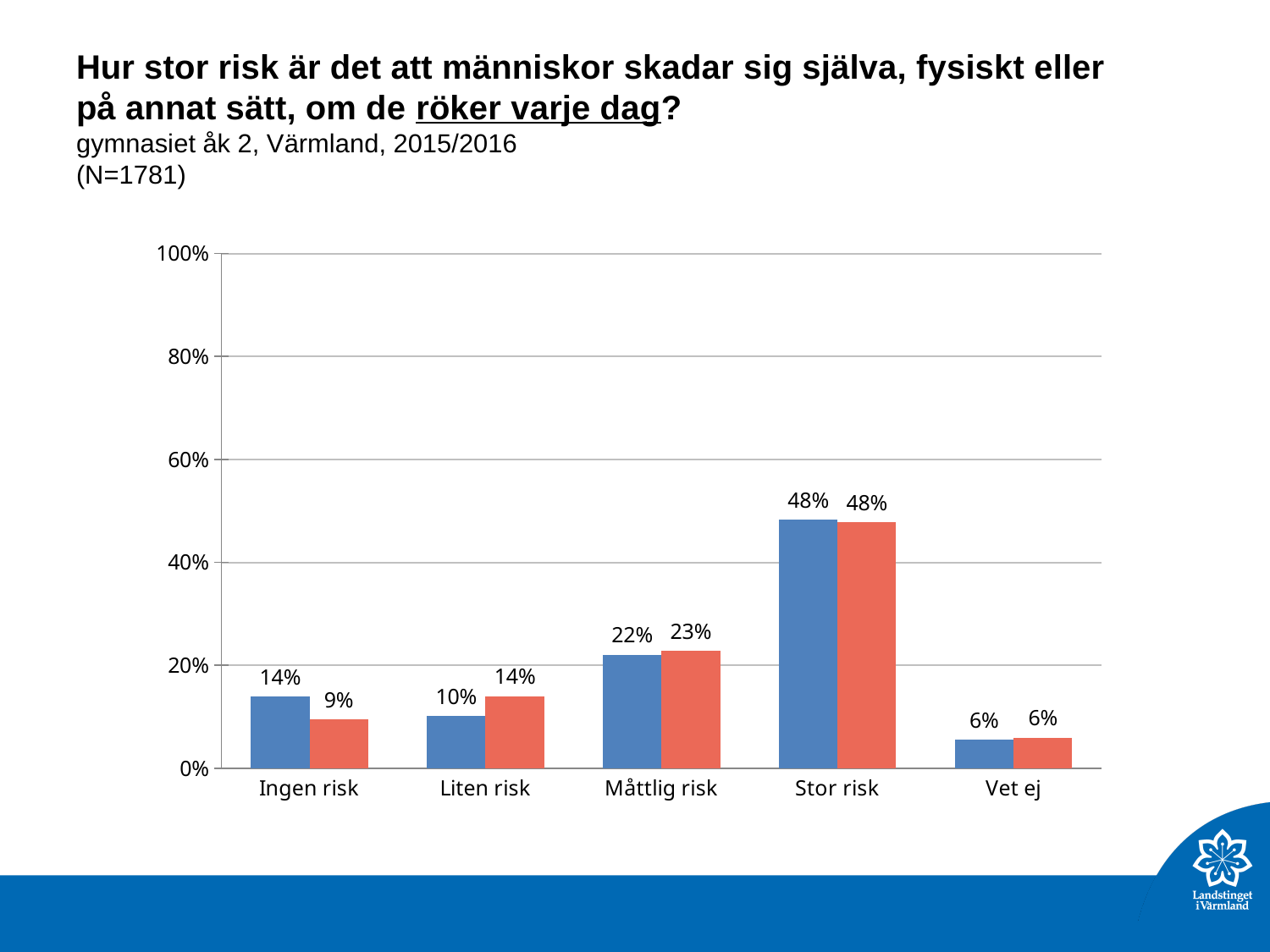
What is the value of the red bar for Ingen risk? 9% What is the sample size (N) stated on the slide? 1781 What kind of chart is shown on the slide? bar chart Is the value of the blue bar for Stor risk greater or less than 40%? greater Which category has the lowest values in the chart? Vet ej What is the difference between the blue bar and the red bar for Ingen risk? 5 percentage points What is the value of the blue bar for Liten risk? 10% Which category has the highest values in the chart? Stor risk For Liten risk, which bar is larger, the blue or the red? red How many categories are shown on the x axis? 5 What is the value of the red bar for Måttlig risk? 23% What is the value of the blue bar for Stor risk? 48%